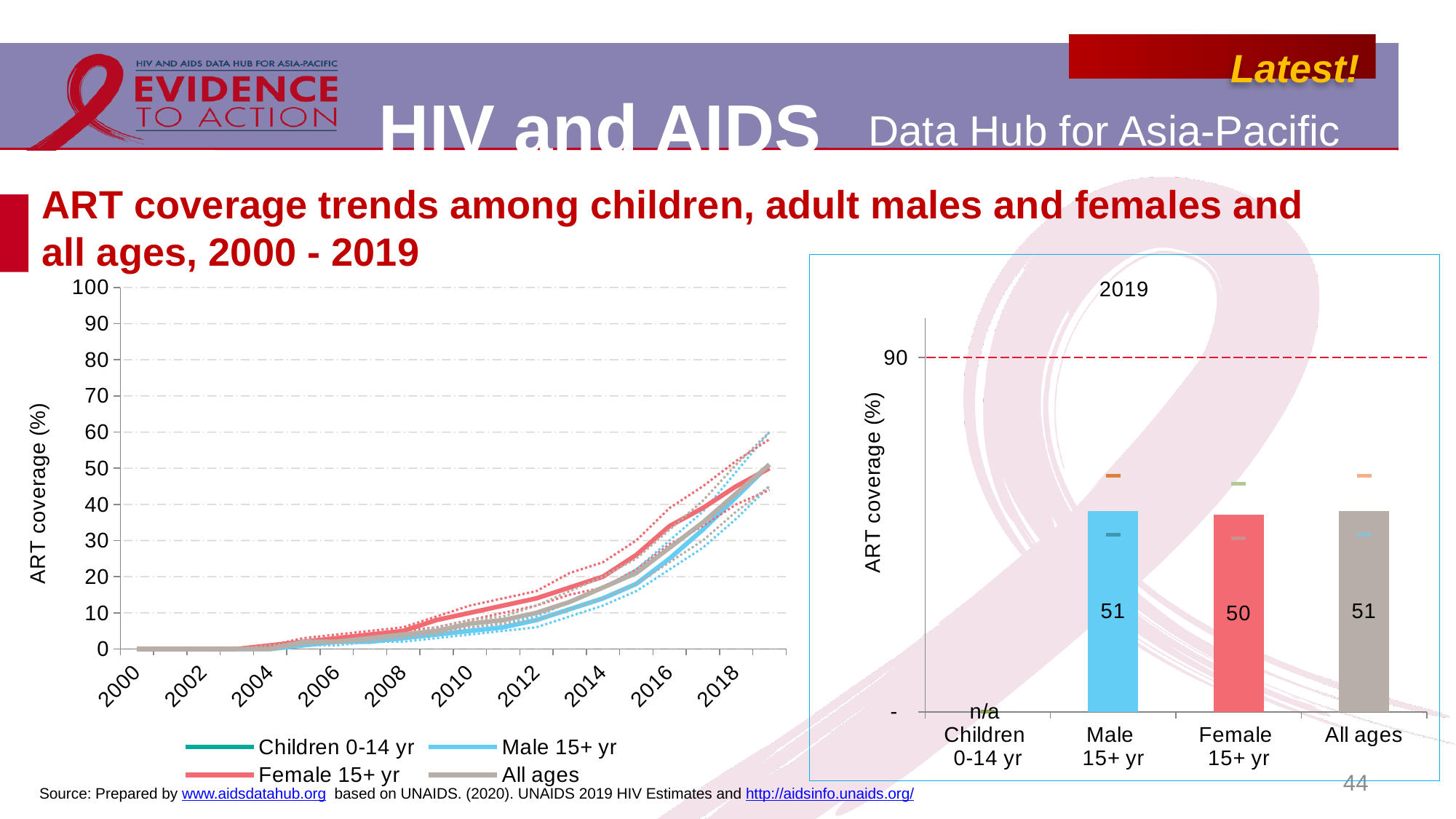
In the 2019 bar chart on the right, what is shown for Children 0-14 yr? n/a In the 2019 bar chart on the right, what is the ART coverage for Male 15+ yr? 51 In the 2019 bar chart on the right, what is the difference between the Male 15+ yr and Female 15+ yr values? 1 In the left line chart, is the value for All ages in 2019 greater or less than 40? greater In the 2019 bar chart on the right, what is the ART coverage for All ages? 51 In the 2019 bar chart on the right, what is the ART coverage for Female 15+ yr? 50 In the 2019 bar chart on the right, which is larger, the value for Male 15+ yr or Female 15+ yr? Male 15+ yr In the left line chart, do the ART coverage values rise or fall from 2000 to 2019? rise In the left line chart, is the value for Female 15+ yr in 2014 greater or less than 30? less In the 2019 bar chart on the right, what value does the red dashed horizontal line mark? 90 How many series does the legend of the left line chart list? 4 What kind of chart is the chart on the left showing ART coverage from 2000 to 2019? line chart